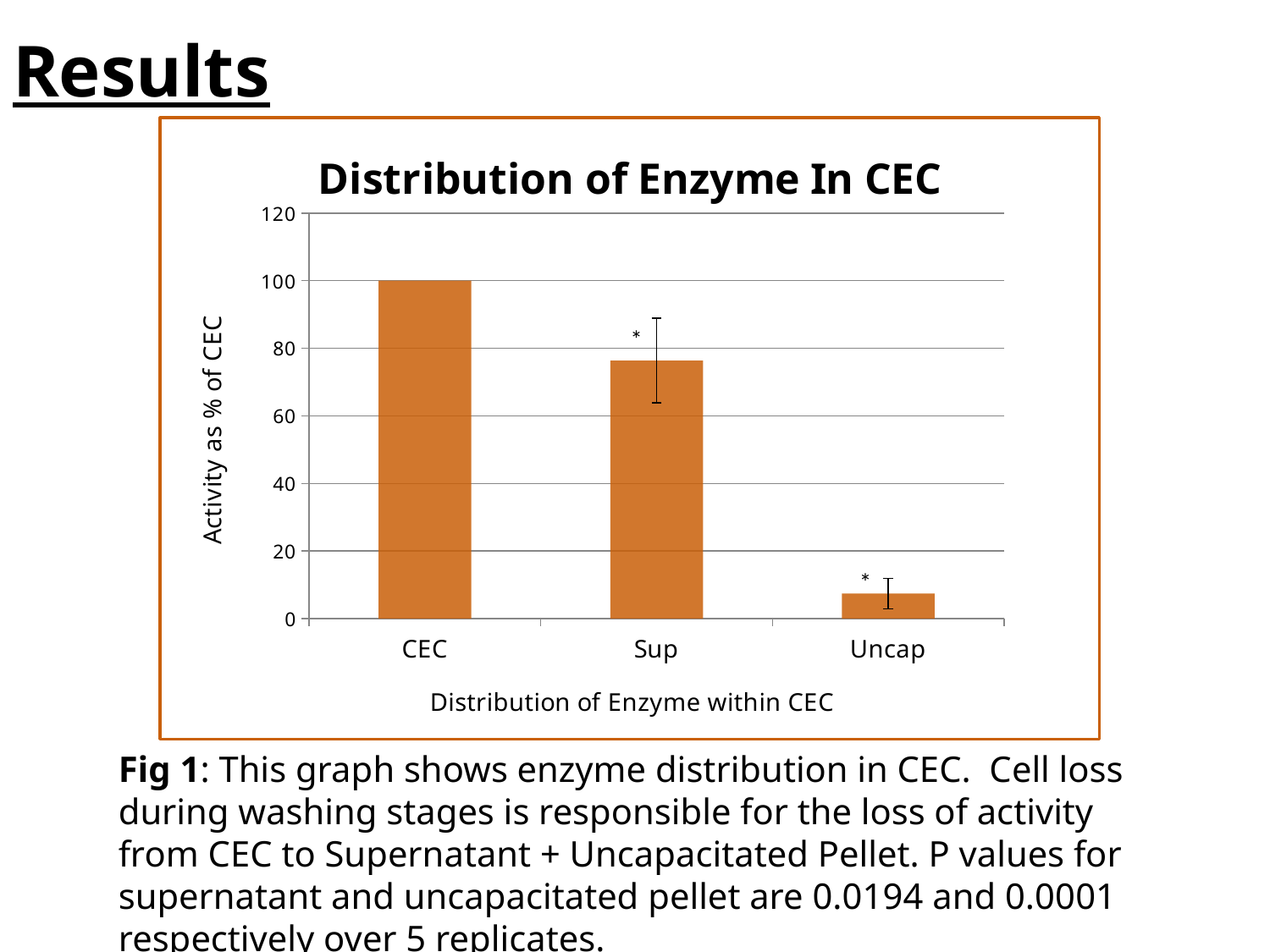
What is the title of the chart? Distribution of Enzyme In CEC What is the label of the y axis? Activity as % of CEC Which has a larger value, Sup or Uncap? Sup How many categories are plotted on the x axis of the chart? 3 Is the value for Sup greater or less than 60? greater Which category has the highest activity as % of CEC? CEC What kind of chart is shown on the slide? bar chart Is the value for Sup greater or less than 80? less Which category has the lowest activity as % of CEC? Uncap What is the activity as % of CEC for the CEC category? 100 Do the bar values rise or fall from left to right along the x axis? fall Is the value for Uncap greater or less than 20? less